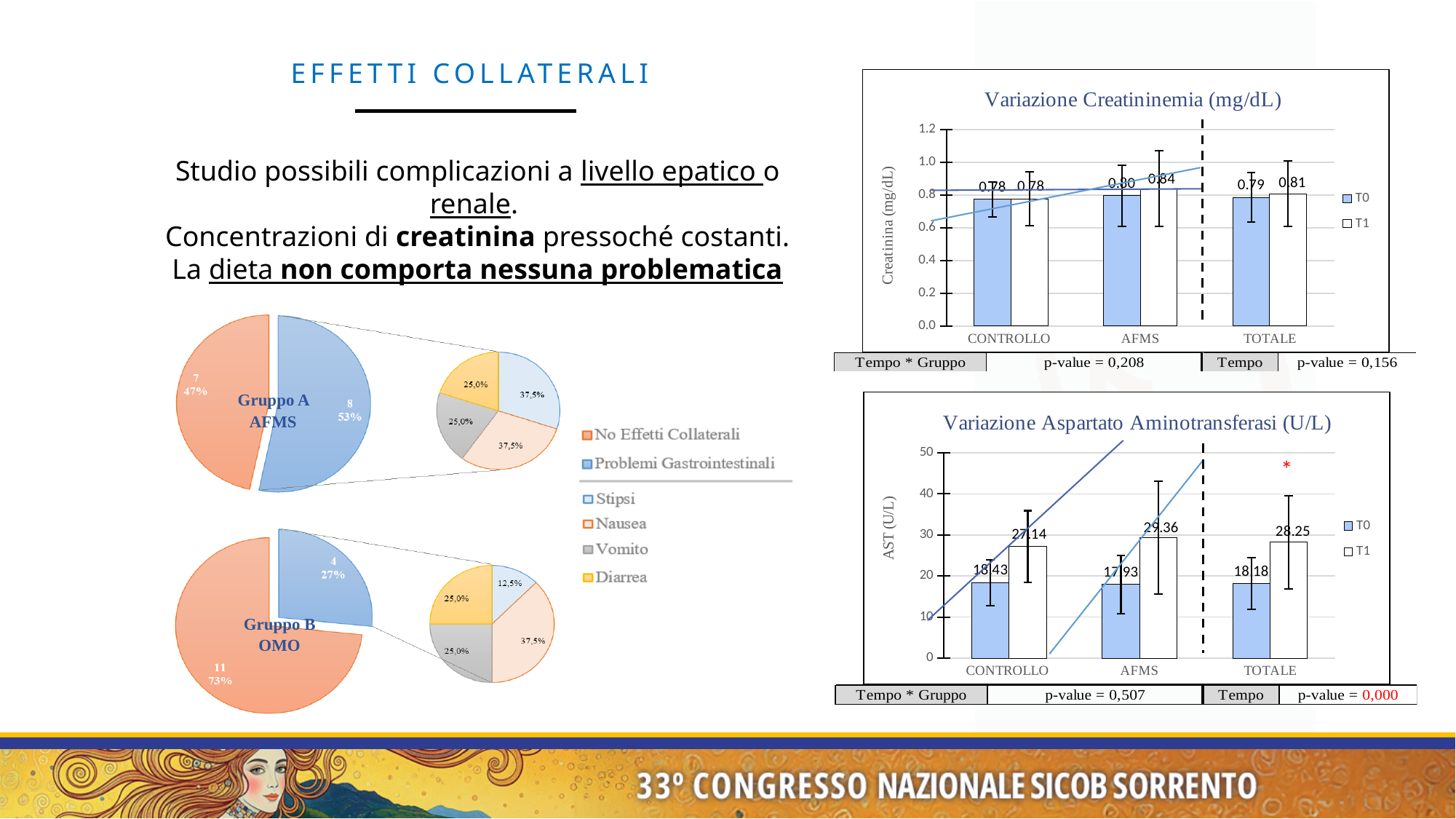
In the Variazione Aspartato Aminotransferasi (U/L) chart, what is the difference between the T1 and T0 values for TOTALE? 10.07 In the Variazione Aspartato Aminotransferasi (U/L) chart, which is larger for AFMS, the T0 value or the T1 value? T1 How many series does the legend of the Variazione Creatininemia (mg/dL) chart list? 2 In the Gruppo B OMO pie chart, what is the count for No Effetti Collaterali? 11 In the Gruppo A AFMS pie chart, what share is Problemi Gastrointestinali? 53% In the Variazione Aspartato Aminotransferasi (U/L) chart, which group has the highest T1 value? AFMS In the Variazione Aspartato Aminotransferasi (U/L) chart, what is the T0 value for AFMS? 17.93 In the Variazione Aspartato Aminotransferasi (U/L) chart, what is the T1 value for CONTROLLO? 27.14 In the Variazione Creatininemia (mg/dL) chart, what is the T0 value for TOTALE? 0.79 In the Variazione Creatininemia (mg/dL) chart, what is the T1 value for AFMS? 0.84 What kind of chart is the Variazione Creatininemia (mg/dL) chart? bar chart In the small breakdown pie next to the Gruppo B OMO pie chart, what share is Stipsi? 12,5%